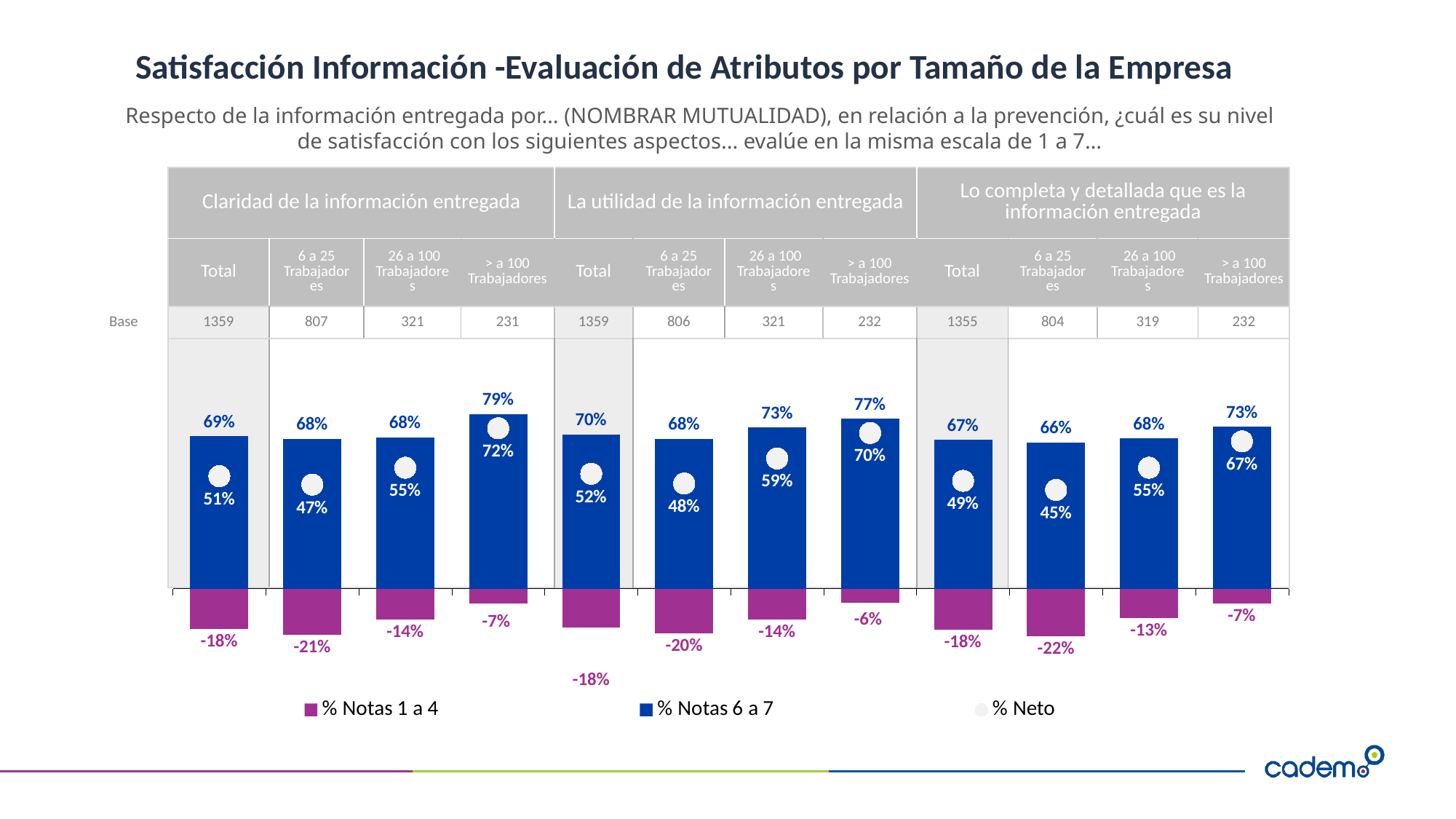
What kind of chart is shown on the slide? Bar chart What is the % Notas 6 a 7 value for Total under 'Claridad de la información entregada'? 69% What is the Base for Total under 'Lo completa y detallada que es la información entregada'? 1355 How many bars of % Notas 6 a 7 are plotted in total on the chart? 12 Which category has the highest % Notas 6 a 7 value across the whole chart? > a 100 Trabajadores (Claridad de la información entregada) What is the difference between the % Notas 6 a 7 values for '> a 100 Trabajadores' and '6 a 25 Trabajadores' under 'Claridad de la información entregada'? 11 percentage points Under 'Lo completa y detallada que es la información entregada', do the % Notas 6 a 7 values rise or fall from '6 a 25 Trabajadores' to '> a 100 Trabajadores'? Rise Which category has the lowest % Neto value across the whole chart? 6 a 25 Trabajadores (Lo completa y detallada que es la información entregada) Under 'La utilidad de la información entregada', which has a larger % Neto: '26 a 100 Trabajadores' or '6 a 25 Trabajadores'? 26 a 100 Trabajadores How many series does the legend list? 3 What is the % Neto value for '> a 100 Trabajadores' under 'La utilidad de la información entregada'? 70% What is the % Notas 1 a 4 value for '6 a 25 Trabajadores' under 'Lo completa y detallada que es la información entregada'? -22%